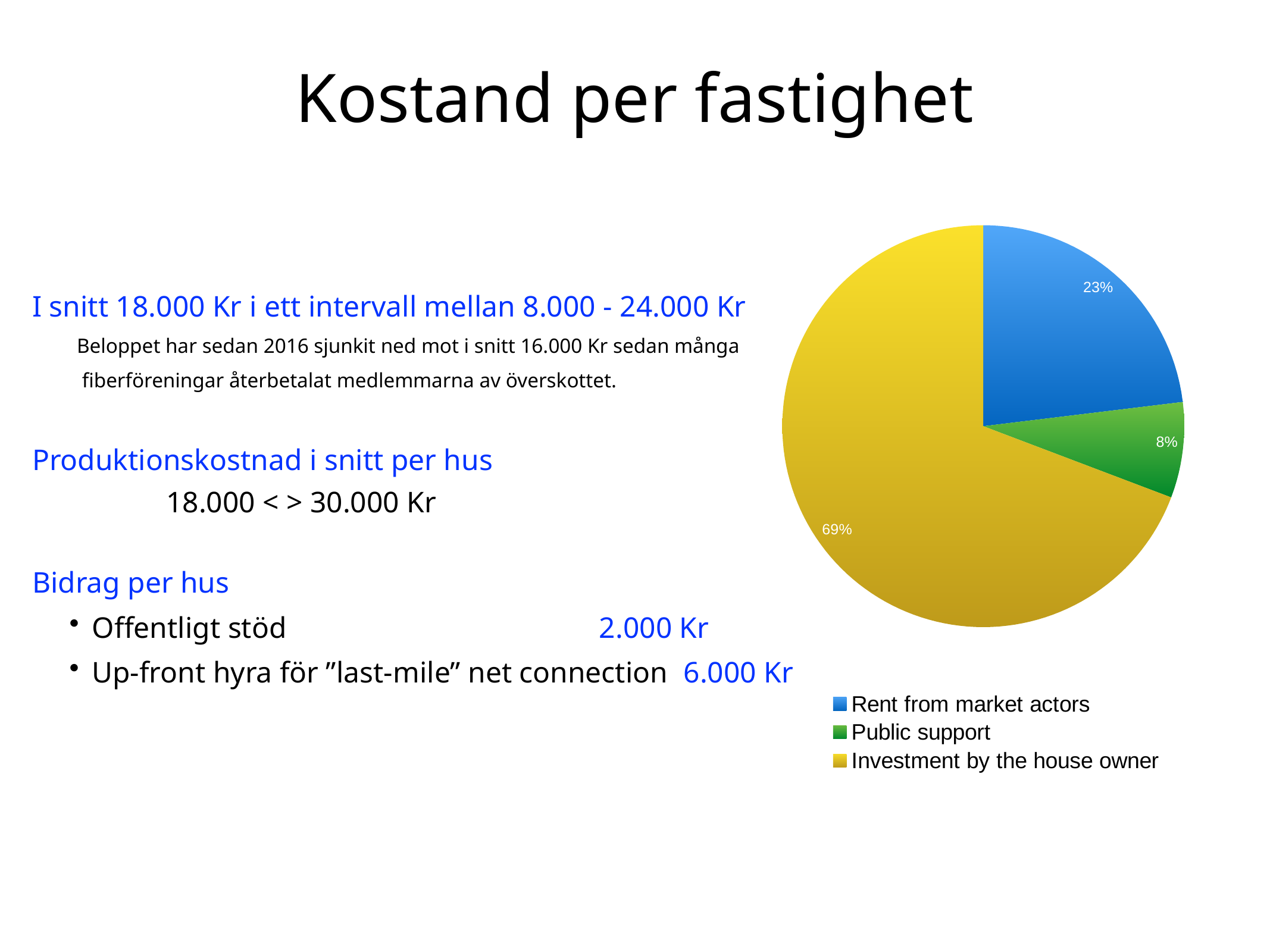
How many slices does the pie chart have? 3 What share of the pie is Investment by the house owner? 69% What share of the pie is Rent from market actors? 23% Which slice of the pie is the smallest? Public support What is the difference in percentage points between Investment by the house owner and Rent from market actors? 46 How many entries does the legend list? 3 Which is larger, Rent from market actors or Public support? Rent from market actors What share of the pie is Public support? 8% What is the difference in percentage points between Rent from market actors and Public support? 15 Which slice of the pie is the largest? Investment by the house owner What kind of chart is shown on the slide? pie chart What colour is the Public support slice? green